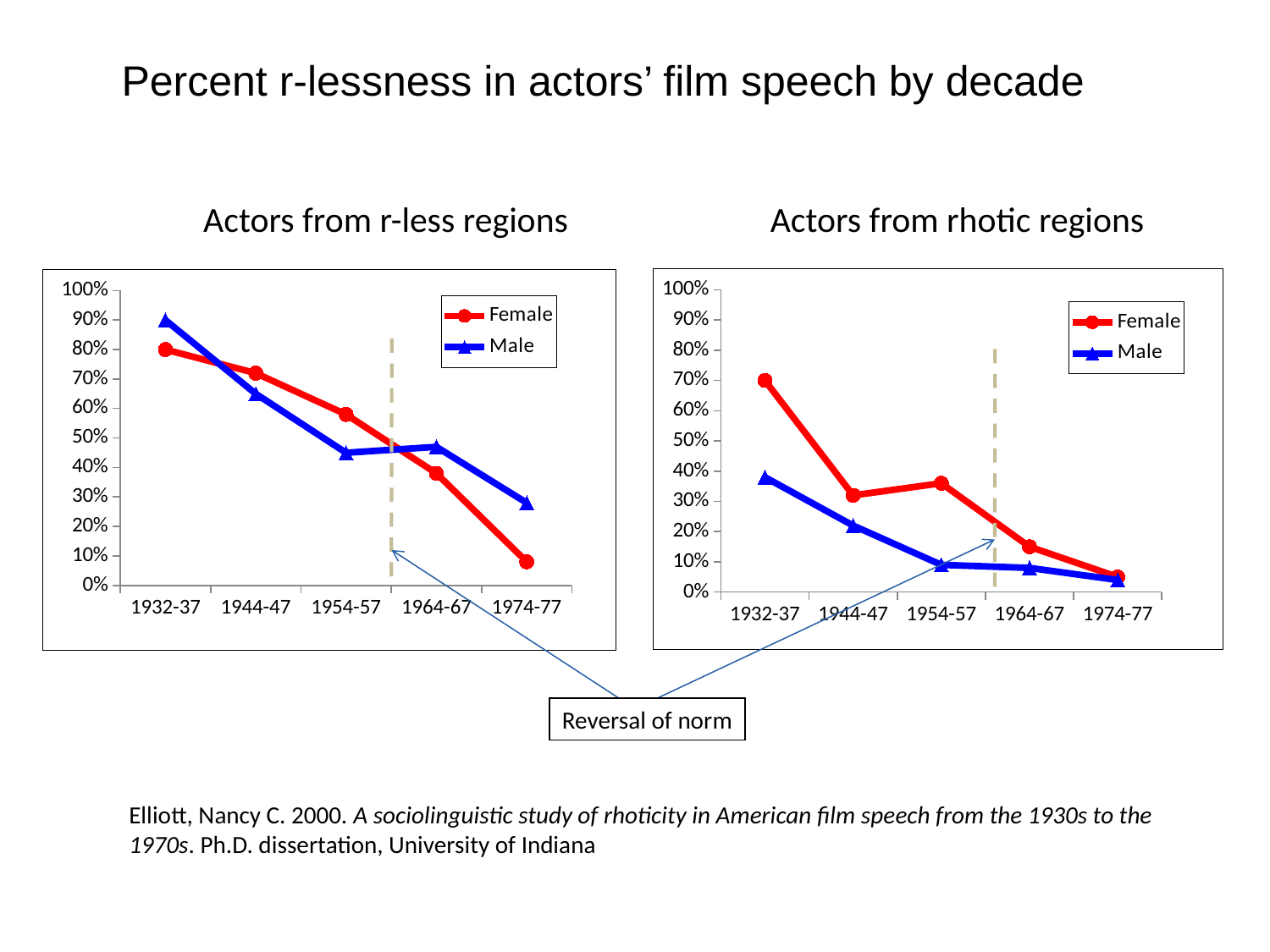
In the 'Actors from r-less regions' chart, is the Female value for 1974-77 greater or less than 10%? less In the 'Actors from r-less regions' chart, is the Male value for 1932-37 greater or less than 80%? greater In the 'Actors from rhotic regions' chart, is the Female value for 1932-37 greater or less than 60%? greater What kind of chart is the 'Actors from r-less regions' chart? Line chart In the 'Actors from r-less regions' chart, does the Female series rise or fall from 1932-37 to 1974-77? Fall In the 'Actors from rhotic regions' chart, in which period is the Female value highest? 1932-37 How many time periods are shown on the x axis of the 'Actors from r-less regions' chart? 5 What does the label pointing to the dashed vertical lines on both charts say? Reversal of norm In the 'Actors from r-less regions' chart, which series has the higher value in 1974-77, Female or Male? Male How many series does the legend of the 'Actors from rhotic regions' chart list? 2 In the 'Actors from rhotic regions' chart, which series has the higher value in 1932-37, Female or Male? Female